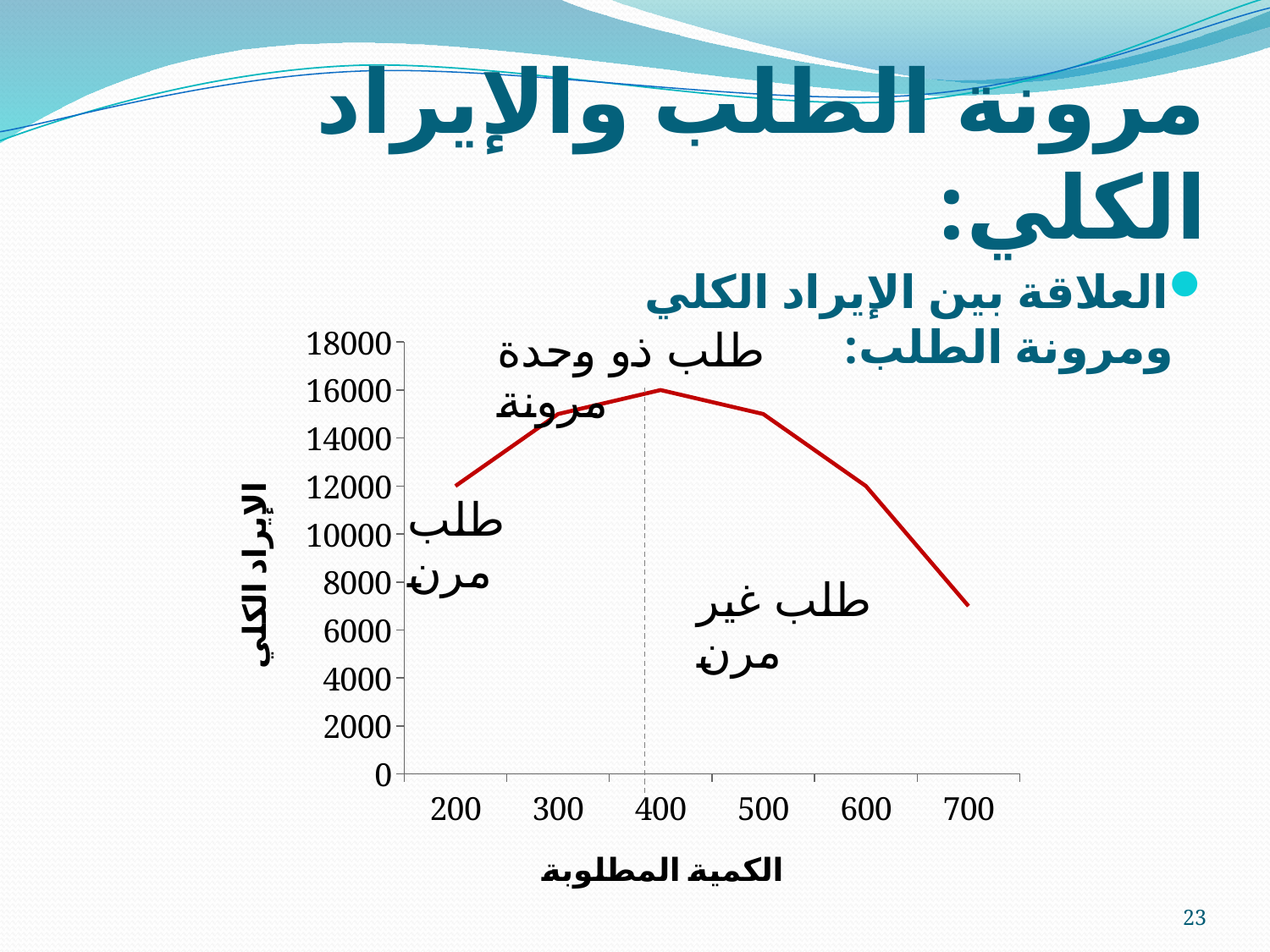
What is the difference between total revenue at quantity 400 and at quantity 200? 4000 Is the total revenue at a quantity of 700 greater or less than 8000? less At which quantity demanded is total revenue lowest? 700 How does total revenue change as quantity demanded increases from 200 to 700? rises to a peak at 400, then falls Is the total revenue at a quantity of 300 greater or less than 14000? greater What is the total revenue at a quantity of 200? 12000 At which quantity demanded (الكمية المطلوبة) is total revenue (الإيراد الكلي) highest? 400 What is the total revenue at a quantity of 400? 16000 How many data points are plotted on the line? 6 What kind of chart is shown on the slide? line chart Which has higher total revenue: quantity 300 or quantity 600? 300 What is the title of the horizontal axis? الكمية المطلوبة